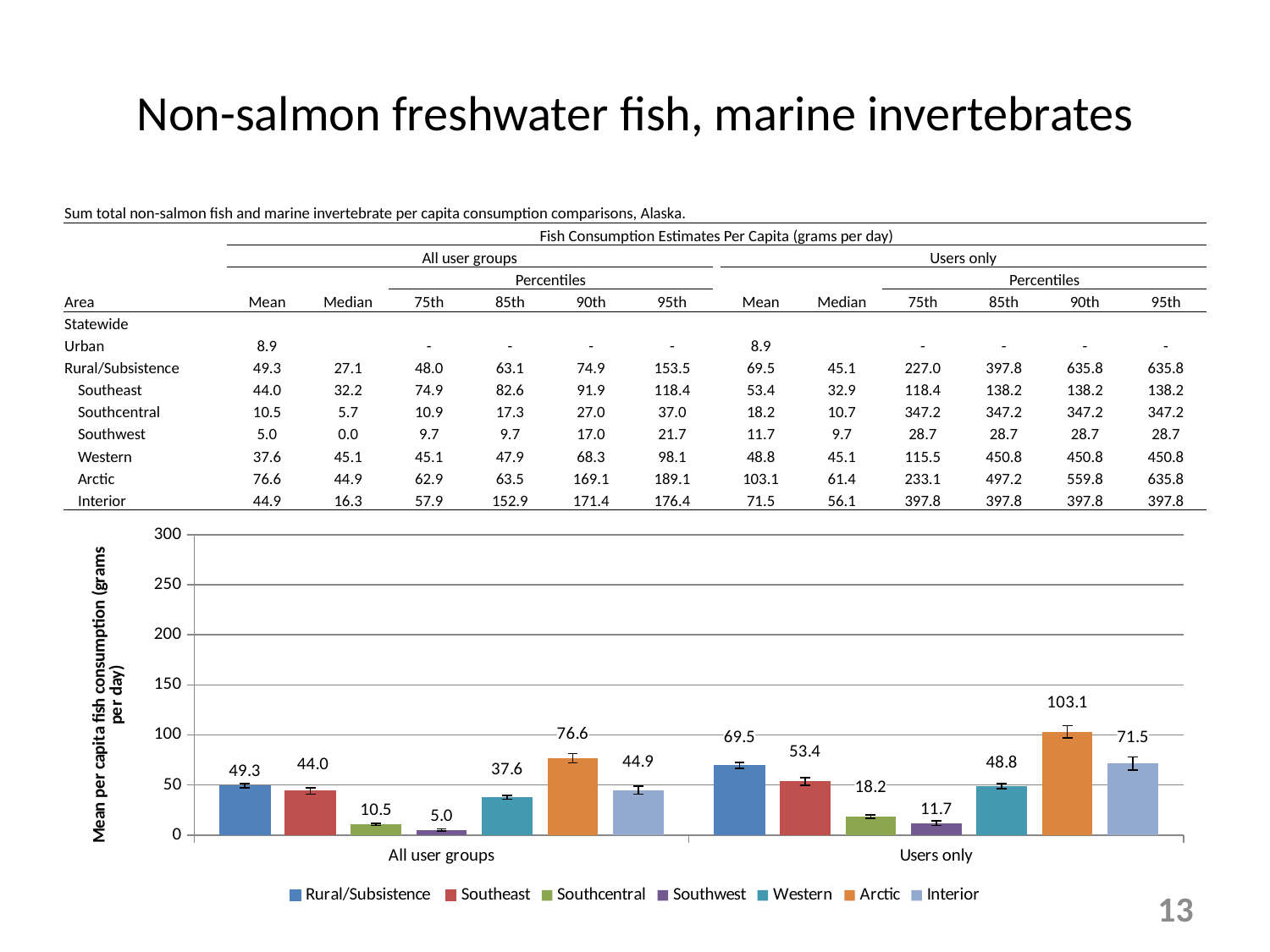
What is the value for Western in the Users only group? 48.8 How many categories are shown on the x axis? 2 What kind of chart is shown on the slide? bar chart Is the value for Interior in the Users only group greater or less than 50? greater Which is larger: the Rural/Subsistence value for All user groups or the Southeast value for All user groups? Rural/Subsistence Which series has the highest value in the All user groups category? Arctic What is the mean per capita fish consumption for Arctic in the Users only group? 103.1 How many series does the legend list? 7 What is the mean per capita fish consumption for Southwest in the All user groups category? 5.0 What is the label of the y axis? Mean per capita fish consumption (grams per day) What is the difference between the Arctic values for Users only and All user groups? 26.5 Which series has the lowest value in the Users only category? Southwest